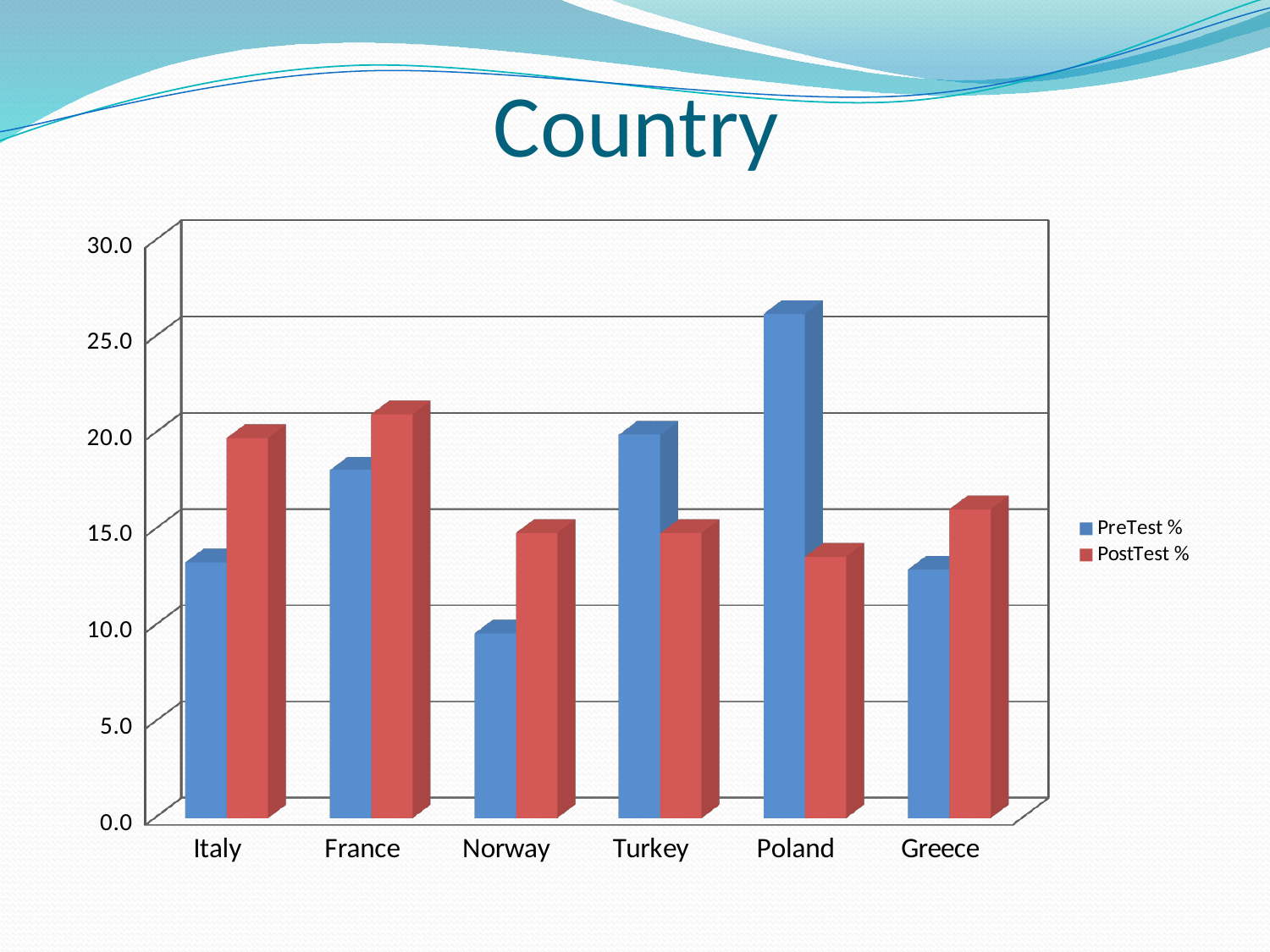
How many countries are shown on the x axis of the chart? 6 Which country has the highest PreTest % value? Poland Which country has the lowest PreTest % value? Norway Which country has the highest PostTest % value? France For Poland, which is larger, the PreTest % or the PostTest % value? PreTest % How many series does the chart's legend list? 2 Is the PreTest % value for Poland greater or less than 25.0? greater Which series is shown in red in the chart? PostTest % Is the PostTest % value for Poland greater or less than 15.0? less What kind of chart is shown on the slide? Bar chart For Italy, which is larger, the PreTest % or the PostTest % value? PostTest % What is the title of the chart? Country